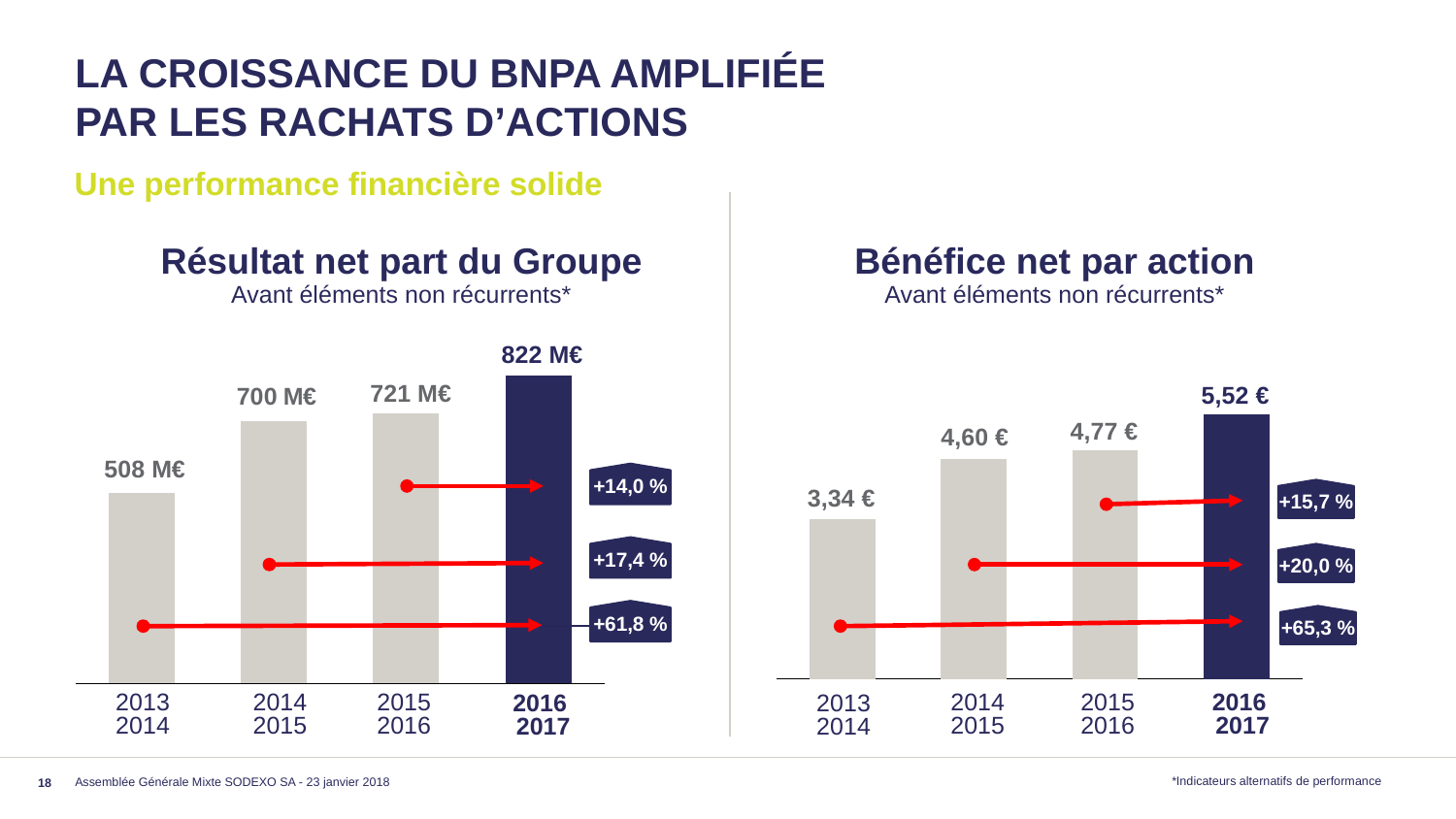
In the 'Bénéfice net par action' chart, which period has the highest value? 2016/2017 In the 'Bénéfice net par action' chart, what is the value for 2014/2015? 4,60 € In the 'Bénéfice net par action' chart, what is the difference between the 2016/2017 value and the 2013/2014 value? 2,18 € How many periods are shown on the x axis of the 'Bénéfice net par action' chart? 4 In the 'Bénéfice net par action' chart, what is the value for 2015/2016? 4,77 € In the 'Résultat net part du Groupe' chart, what is the difference between the 2016/2017 value and the 2015/2016 value? 101 M€ What kind of chart is the 'Résultat net part du Groupe' chart? Bar chart In the 'Résultat net part du Groupe' chart, what is the value for 2016/2017? 822 M€ In the 'Résultat net part du Groupe' chart, which period has the lowest value? 2013/2014 In the 'Bénéfice net par action' chart, what growth percentage is shown between 2013/2014 and 2016/2017? +65,3 % In the 'Résultat net part du Groupe' chart, which is larger: the value for 2014/2015 or the value for 2013/2014? 2014/2015 In the 'Résultat net part du Groupe' chart, what is the value for 2013/2014? 508 M€